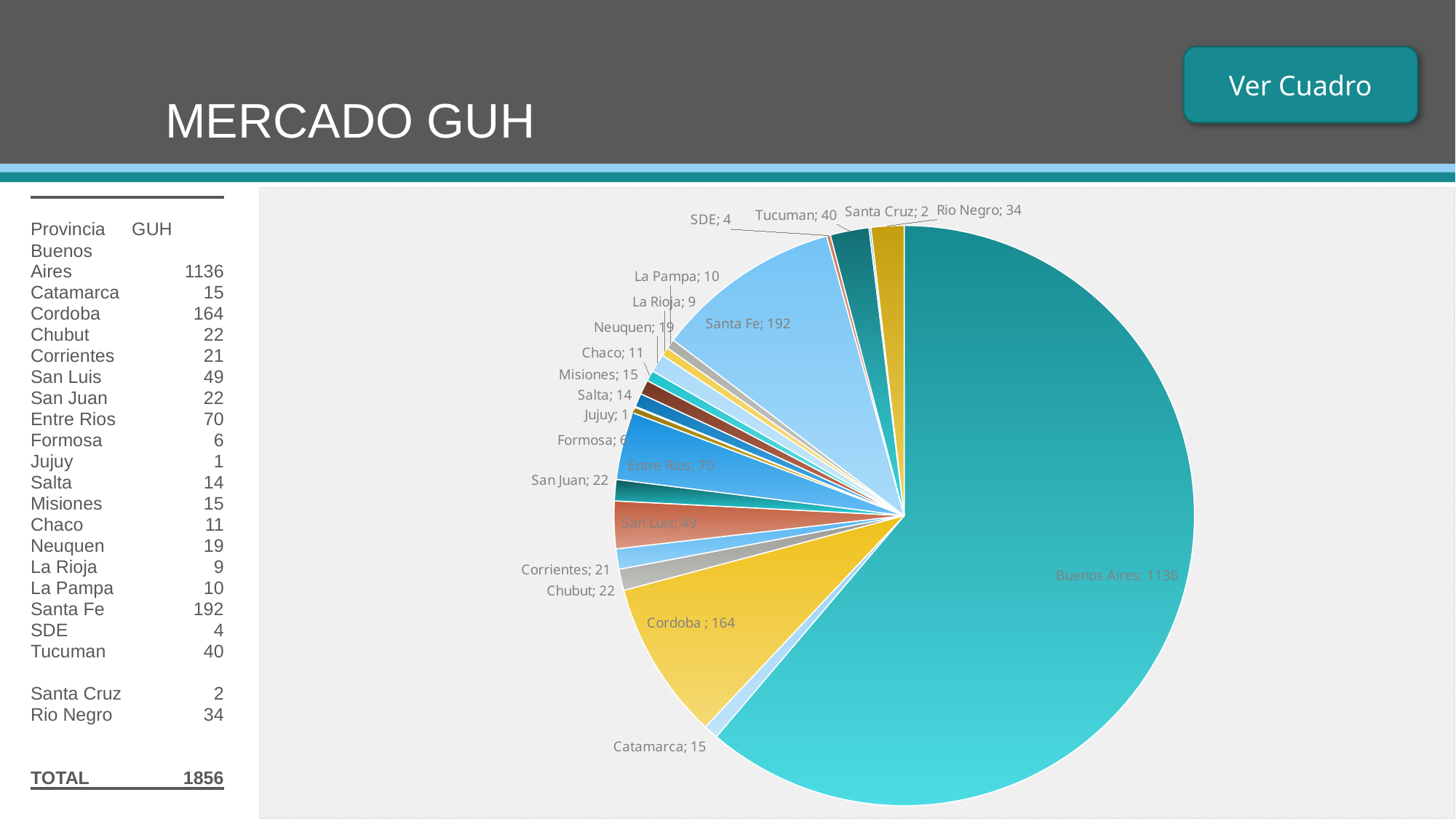
What is the value for Santa Fe in the pie chart? 192 What type of chart is shown on the slide? pie chart What is the value for Rio Negro in the pie chart? 34 What share of the total does Buenos Aires represent in the pie chart? 61.2% Which province has the smallest slice in the pie chart? Jujuy What is the difference between the values for Santa Fe and Cordoba? 28 How many slices does the pie chart have? 21 What is the value for Entre Rios in the pie chart? 70 What is the title of the slide containing the pie chart? MERCADO GUH Which province has the largest slice in the pie chart? Buenos Aires What is the difference between the values for Buenos Aires and Santa Fe? 944 Which is larger, the value for Tucuman or the value for Rio Negro? Tucuman